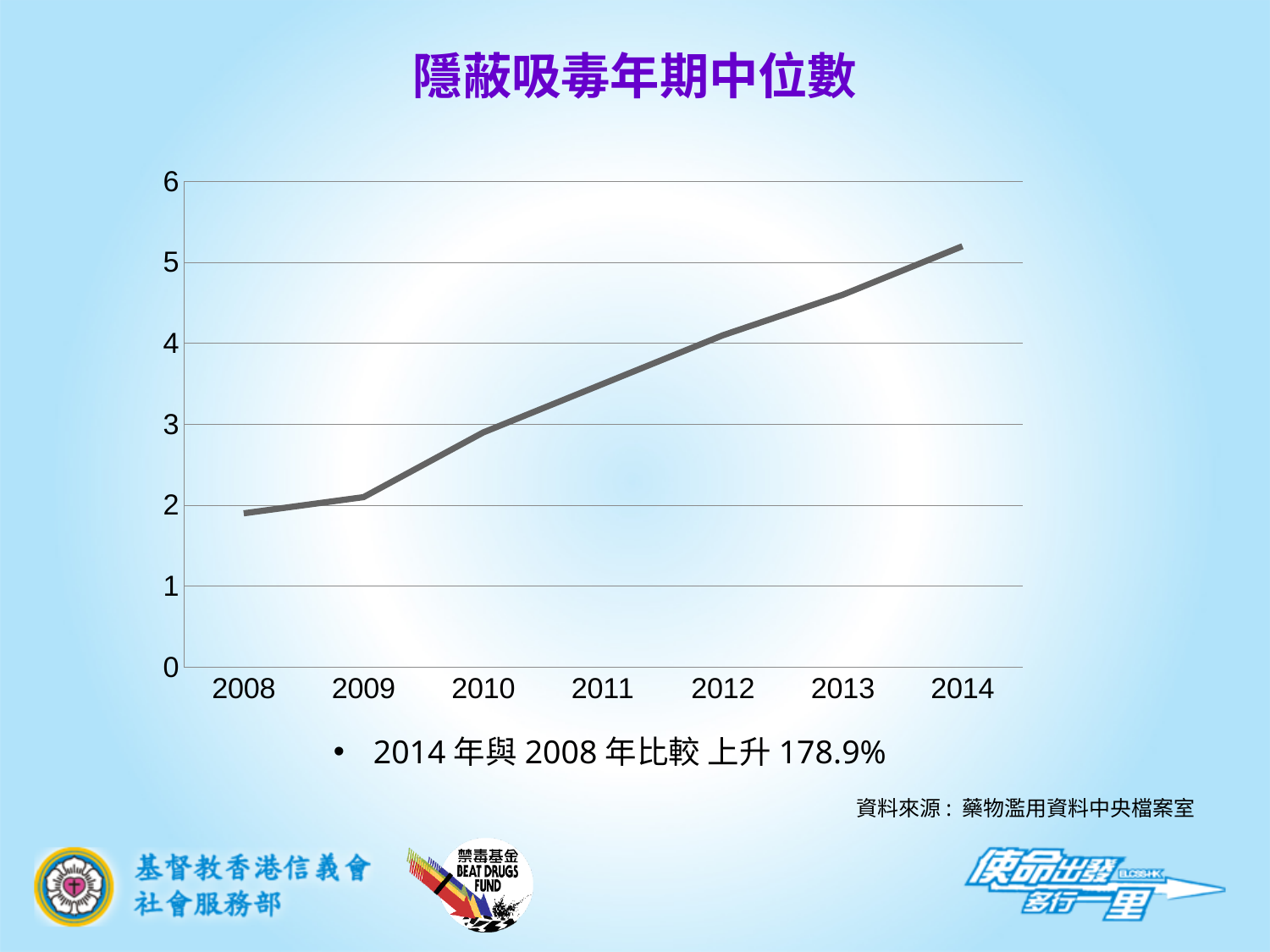
Which is larger, the value for 2012 or the value for 2009? 2012 Is the value for 2014 greater or less than 5? greater Which year has the lowest value in the chart? 2008 What kind of chart is shown on the slide? line chart Do the values rise or fall from 2008 to 2014? rise Is the value for 2010 greater or less than 2? greater Is the value for 2011 greater or less than 3? greater How many years are plotted along the x axis of the chart? 7 Which year has the highest value in the chart? 2014 What is the title of the chart? 隱蔽吸毒年期中位數